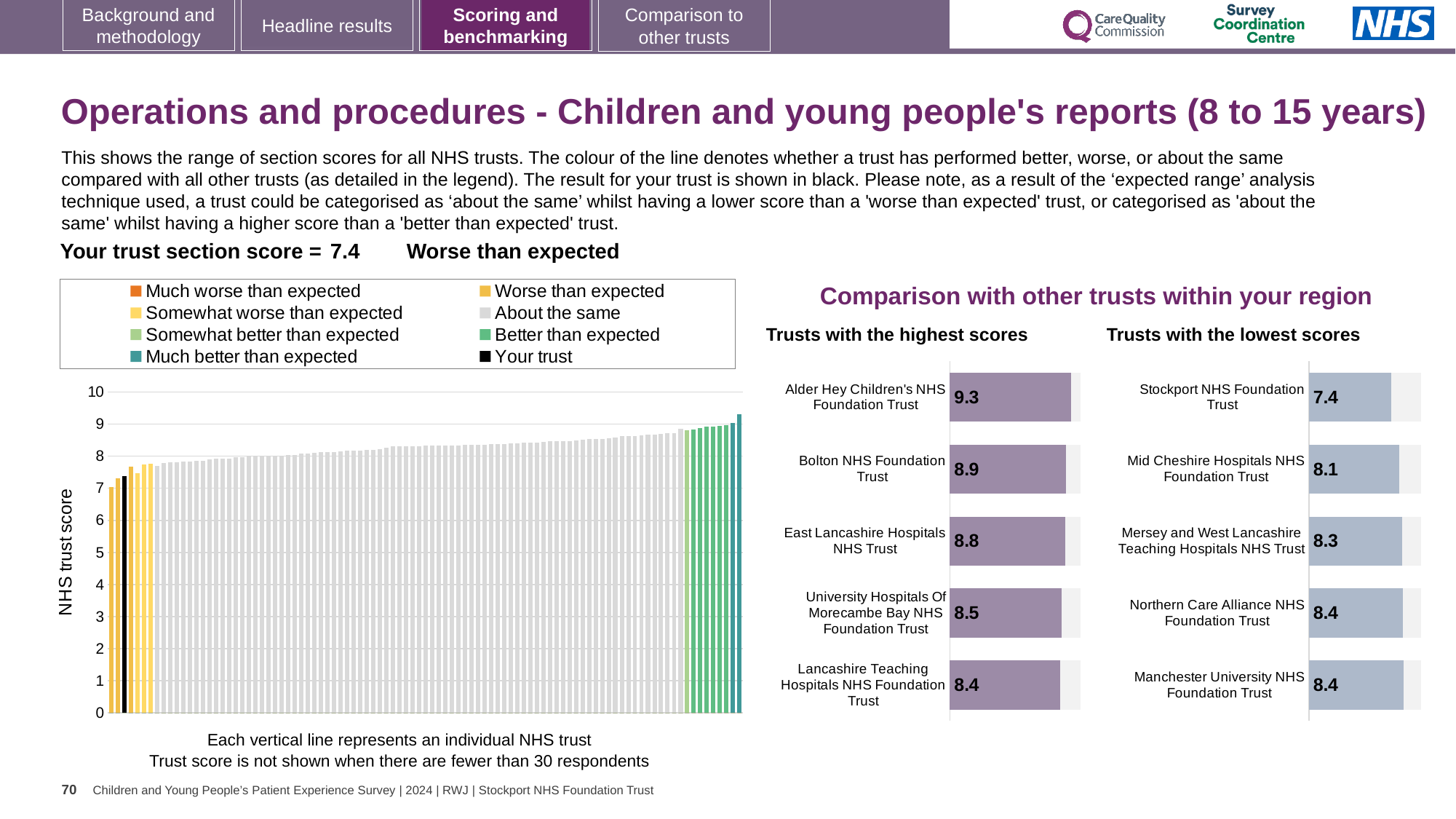
In the 'Trusts with the highest scores' chart, what is the difference between the scores of Alder Hey Children's NHS Foundation Trust and Lancashire Teaching Hospitals NHS Foundation Trust? 0.9 In the 'Trusts with the highest scores' chart, what is the score for Alder Hey Children's NHS Foundation Trust? 9.3 What kind of chart is the NHS trust score chart on the left of the slide? bar chart In the 'Trusts with the lowest scores' chart, how much higher is Mid Cheshire Hospitals NHS Foundation Trust's score than Stockport NHS Foundation Trust's? 0.7 In the 'Trusts with the highest scores' chart, which has the larger score: Bolton NHS Foundation Trust or East Lancashire Hospitals NHS Trust? Bolton NHS Foundation Trust In the 'Trusts with the lowest scores' chart, what is the score for Mid Cheshire Hospitals NHS Foundation Trust? 8.1 How many trusts are listed in the 'Trusts with the highest scores' chart? 5 In the NHS trust score chart on the left, do the values rise or fall from left to right? rise In the 'Trusts with the highest scores' chart, which trust has the highest score? Alder Hey Children's NHS Foundation Trust In the 'Trusts with the lowest scores' chart, which trust has the lowest score? Stockport NHS Foundation Trust How many entries does the legend of the NHS trust score chart on the left list? 8 In the 'Trusts with the lowest scores' chart, what is the score for Stockport NHS Foundation Trust? 7.4